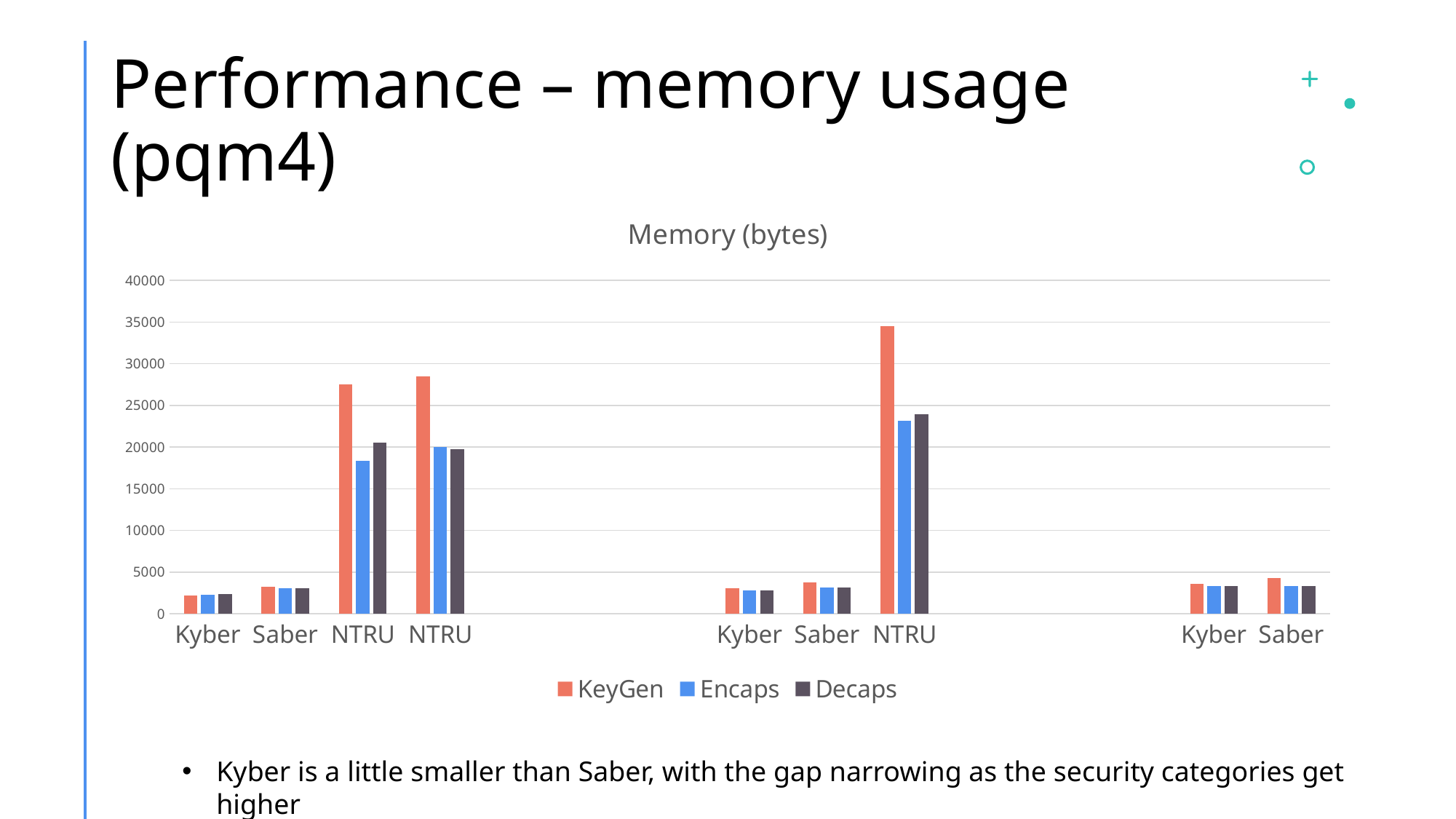
In the leftmost group, which has the larger KeyGen value, Kyber or Saber? Saber Is the KeyGen value for the NTRU category in the middle group greater or less than 30000? greater Which series are listed in the chart legend? KeyGen, Encaps, Decaps How many labelled categories are shown along the x axis? 9 Which category has the tallest KeyGen bar in the chart? NTRU Is the KeyGen value for the leftmost Kyber category greater or less than 5000? less Is the KeyGen value for the first NTRU category (leftmost group) greater or less than 25000? greater What is the title of the chart? Memory (bytes) How many series does the legend list? 3 What kind of chart is shown on the slide? bar chart